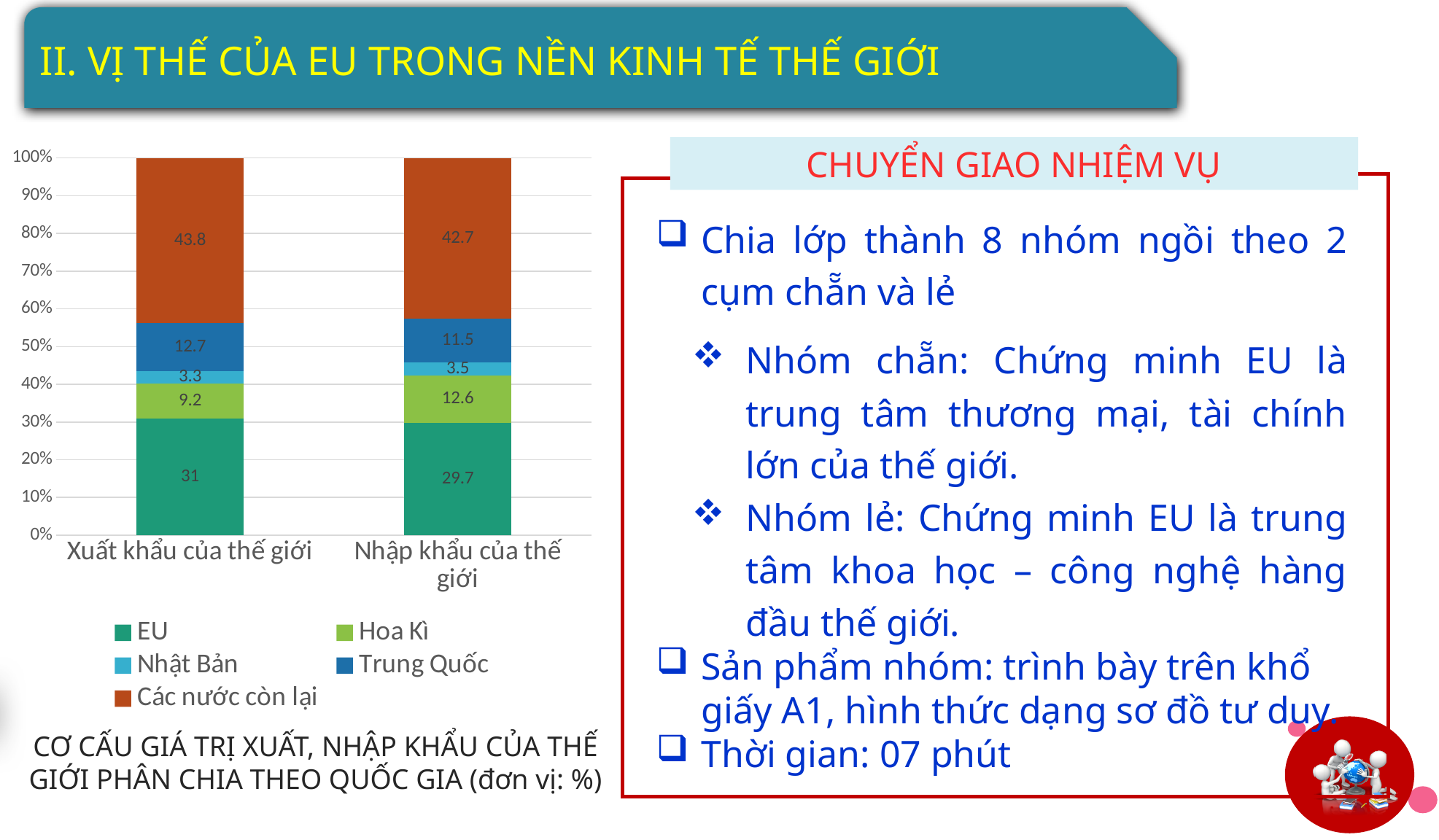
What is the value for Trung Quốc in the "Xuất khẩu của thế giới" bar? 12.7 Which series has the smallest segment in the "Nhập khẩu của thế giới" bar? Nhật Bản How many series does the chart legend list? 5 What is the value for Nhật Bản in the "Nhập khẩu của thế giới" bar? 3.5 What is the difference between the EU value for "Xuất khẩu của thế giới" and for "Nhập khẩu của thế giới"? 1.3 What is the value for Hoa Kì in the "Nhập khẩu của thế giới" bar? 12.6 What kind of chart is shown on the slide? Stacked bar chart What is the value for EU in the "Xuất khẩu của thế giới" bar? 31 What is the value for Các nước còn lại in the "Nhập khẩu của thế giới" bar? 42.7 Which is larger: the Hoa Kì value for "Xuất khẩu của thế giới" or for "Nhập khẩu của thế giới"? Nhập khẩu của thế giới How many categories are shown on the x axis of the chart? 2 Which series has the largest segment in the "Xuất khẩu của thế giới" bar? Các nước còn lại